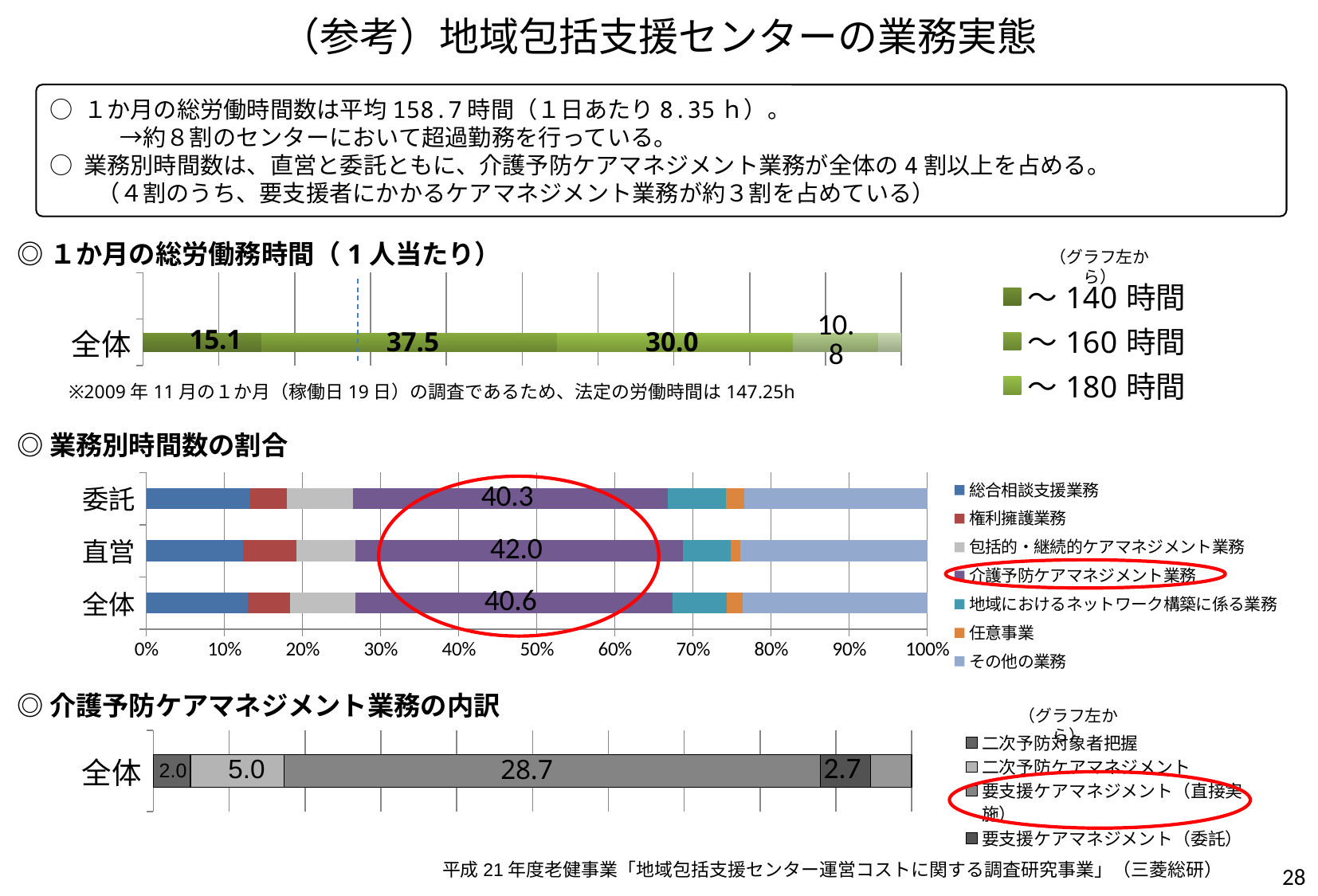
In the 業務別時間数の割合 chart, which category has the highest value for 介護予防ケアマネジメント業務? 直営 In the 業務別時間数の割合 chart, how many categories are shown on the vertical axis? 3 In the 介護予防ケアマネジメント業務の内訳 chart, how many series does the legend list? 4 In the 介護予防ケアマネジメント業務の内訳 chart, what is the value of 要支援ケアマネジメント（直接実施）? 28.7 In the １か月の総労働務時間（１人当たり） chart, what is the value of the ～160時間 segment? 37.5 In the 業務別時間数の割合 chart, how many series does the legend list? 7 What kind of chart is the 業務別時間数の割合 chart? Stacked bar chart In the 業務別時間数の割合 chart, what is the value of 介護予防ケアマネジメント業務 for 委託? 40.3 In the １か月の総労働務時間（１人当たり） chart, what is the difference between the ～160時間 segment and the ～180時間 segment? 7.5 In the 業務別時間数の割合 chart, what is the value of 介護予防ケアマネジメント業務 for 直営? 42.0 In the 業務別時間数の割合 chart, which category has the lowest value for 介護予防ケアマネジメント業務? 委託 In the 業務別時間数の割合 chart, what is the difference between the 介護予防ケアマネジメント業務 values for 直営 and 委託? 1.7